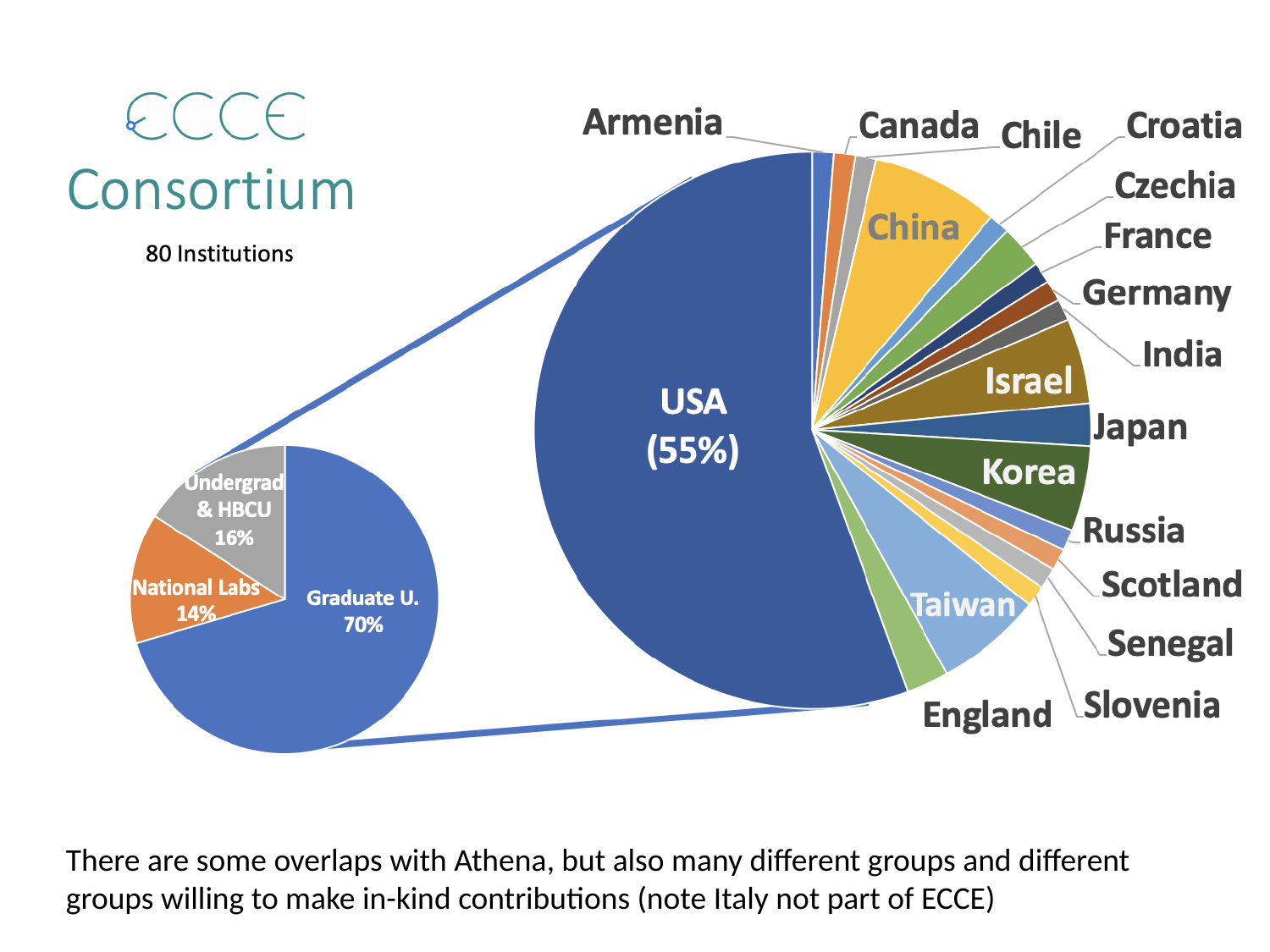
In the large pie chart of countries, which slice is larger, China or Armenia? China In the large pie chart of countries, which country has the largest slice? USA In the small pie chart breaking down the USA, what percentage is Graduate U.? 70% In the small pie chart breaking down the USA, which category has the smallest share? National Labs What kind of chart is the large chart showing countries? Pie chart In the small pie chart breaking down the USA, what percentage is National Labs? 14% In the large pie chart of countries, how many countries are labelled? 19 In the small pie chart breaking down the USA, which category has the largest share? Graduate U. In the small pie chart breaking down the USA, how many slices are there? 3 In the small pie chart breaking down the USA, what is the difference between the Graduate U. share and the National Labs share? 56% In the small pie chart breaking down the USA, what percentage is Undergrad & HBCU? 16% In the large pie chart of countries, what share is shown for USA? 55%